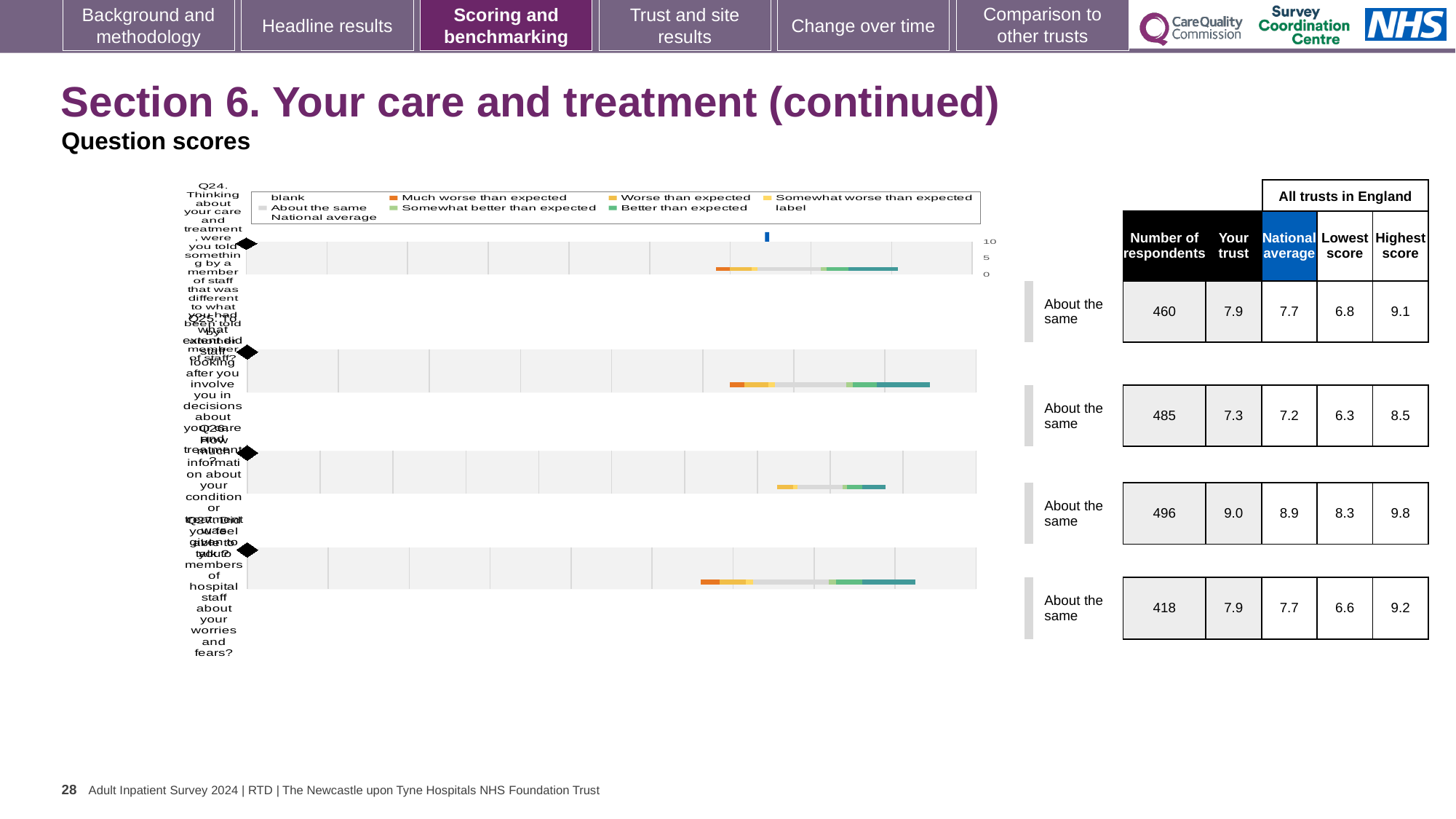
What is the 'Your trust' score for Q24 (told something different by another member of staff)? 7.9 What is the national average for Q25 (staff involving you in decisions about your care and treatment)? 7.2 What kind of chart is shown on the slide? bar chart What benchmark category is shown for Q25? About the same Which question has the lowest number of respondents? Q27 Which question has the highest 'Your trust' score? Q26 How many question bars are plotted in the chart? 4 Which legend entry is shown in orange? Much worse than expected What is the number of respondents for Q26 (how much information about your condition or treatment was given to you)? 496 What is the highest score among all trusts in England for Q27 (able to talk to staff about worries and fears)? 9.2 What is the difference between the 'Your trust' score and the national average for Q26? 0.1 Which is larger, the 'Your trust' score for Q25 or for Q27? Q27